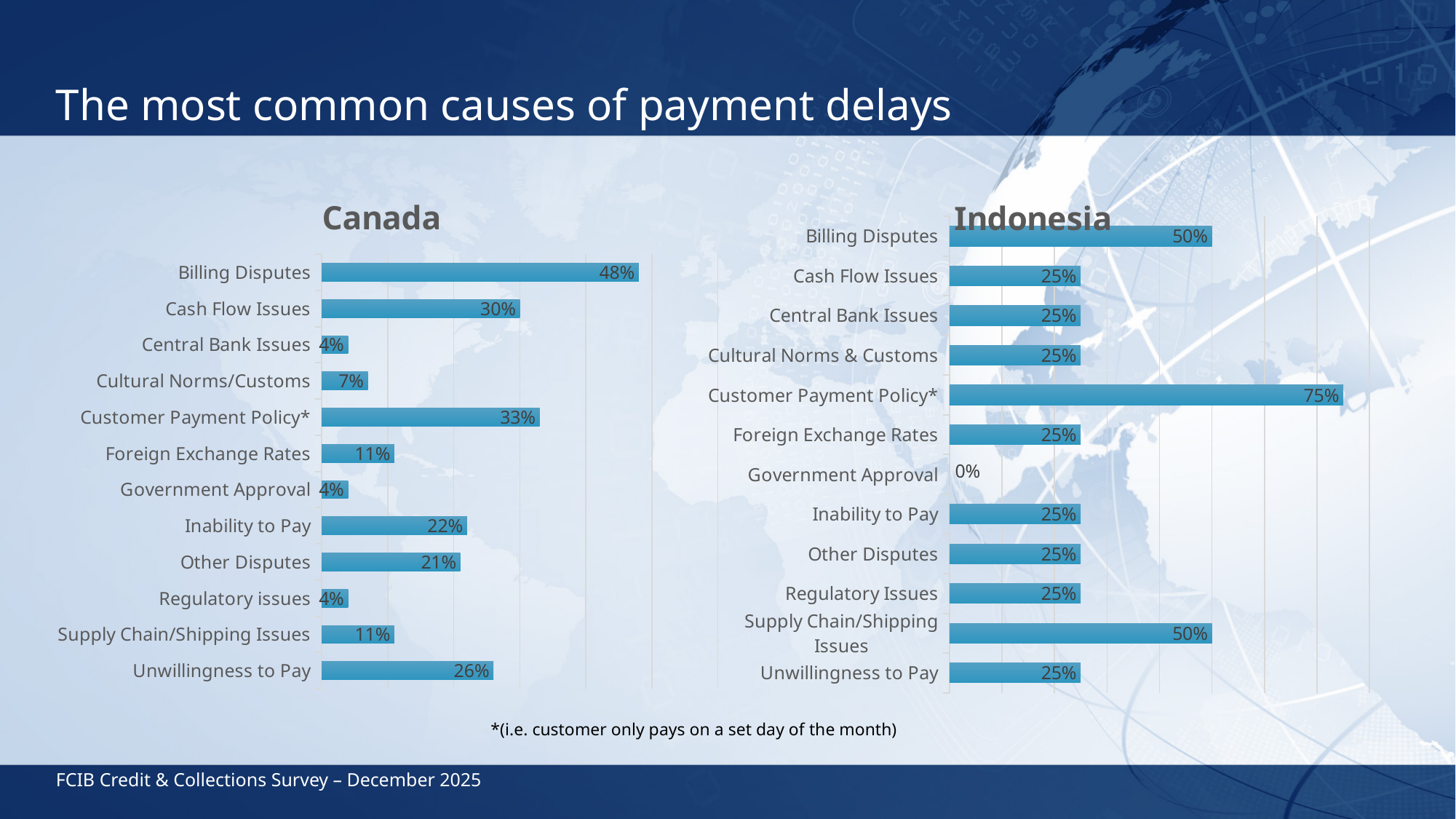
In the Canada chart, what is the value for Foreign Exchange Rates? 11% In the Indonesia chart, what is the difference between Customer Payment Policy* and Billing Disputes? 25% In the Indonesia chart, which is larger: Supply Chain/Shipping Issues or Foreign Exchange Rates? Supply Chain/Shipping Issues What kind of chart is the Indonesia chart? Bar chart In the Canada chart, what is the value for Billing Disputes? 48% In the Indonesia chart, what is the value for Customer Payment Policy*? 75% In the Canada chart, what is the difference between Billing Disputes and Cash Flow Issues? 18% In the Canada chart, which is larger: Inability to Pay or Unwillingness to Pay? Unwillingness to Pay How many categories are shown in the Canada chart? 12 In the Canada chart, which category has the highest value? Billing Disputes In the Indonesia chart, what is the value for Government Approval? 0% In the Indonesia chart, which category has the lowest value? Government Approval